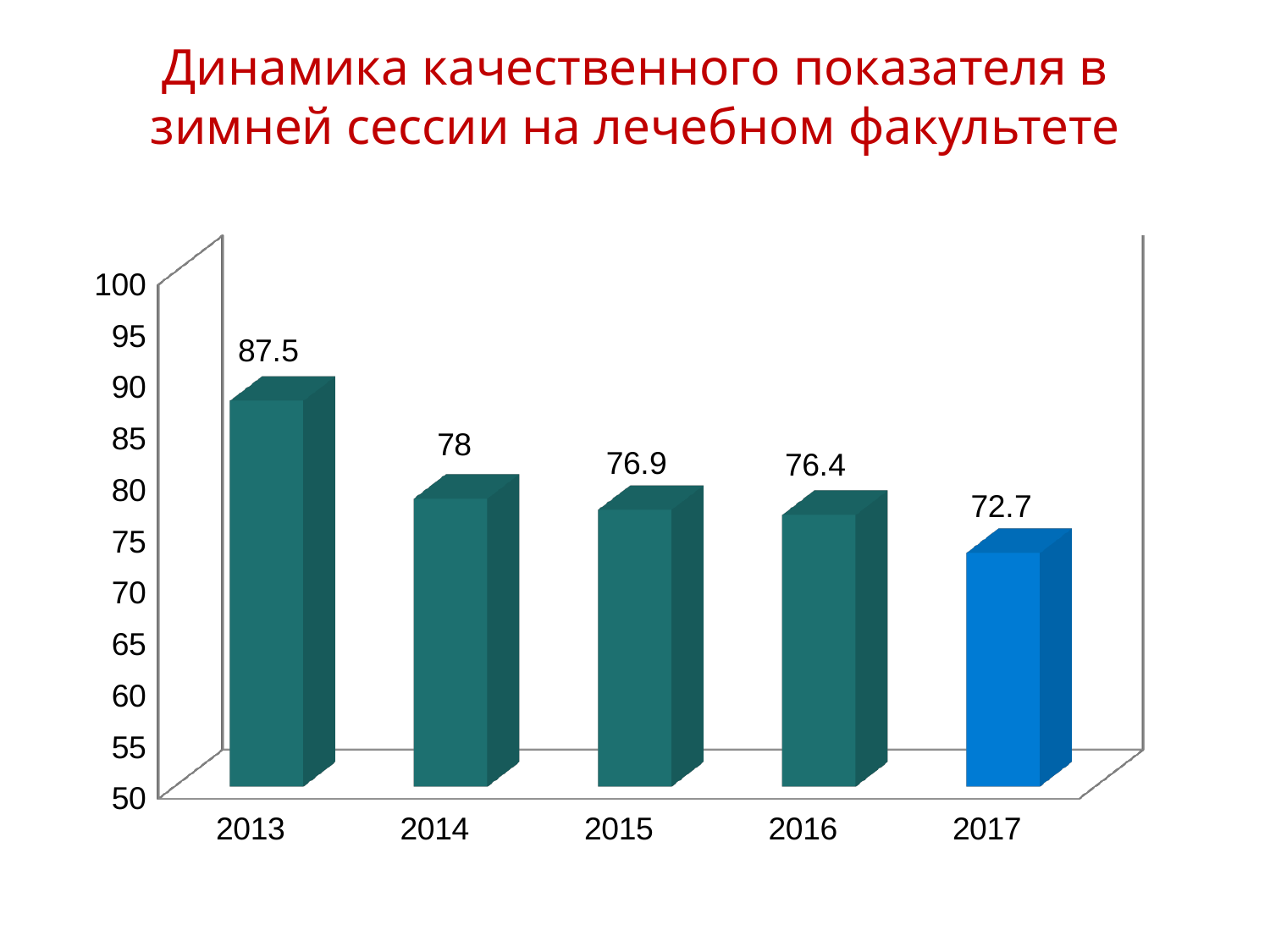
What is the difference between the values for 2013 and 2017? 14.8 Which year has the lowest value? 2017 What is the difference between the values for 2014 and 2016? 1.6 Is the value for 2016 greater or less than 80? less What is the value for 2013? 87.5 Which year has the highest value? 2013 How many years are shown on the x axis? 5 What is the value for 2017? 72.7 What is the value for 2015? 76.9 What kind of chart is shown on the slide? bar chart Do the values rise or fall from 2013 to 2017? fall Which is larger, the value for 2014 or the value for 2017? 2014